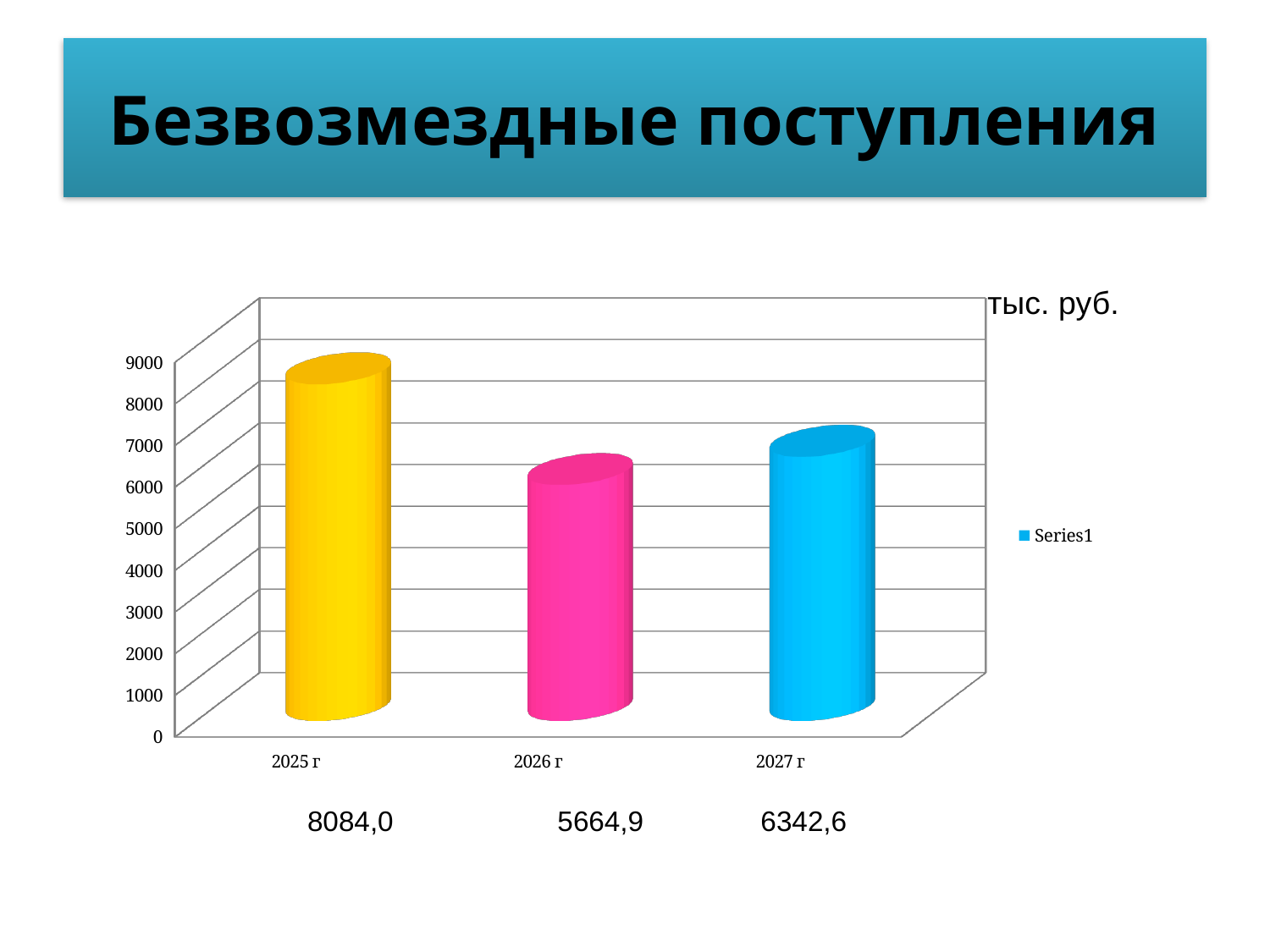
How many categories are shown on the x axis? 3 What is the difference between the values for 2025 г and 2026 г? 2419,1 What is the difference between the values for 2027 г and 2026 г? 677,7 What is the title of the slide? Безвозмездные поступления What is the value for 2026 г? 5664,9 Which is larger, the value for 2026 г or the value for 2027 г? 2027 г What is the value for 2027 г? 6342,6 Which year has the lowest value? 2026 г Which year has the highest value? 2025 г What is the value for 2025 г? 8084,0 What kind of chart is shown on the slide? bar chart Is the value for 2025 г greater or less than 7000? greater